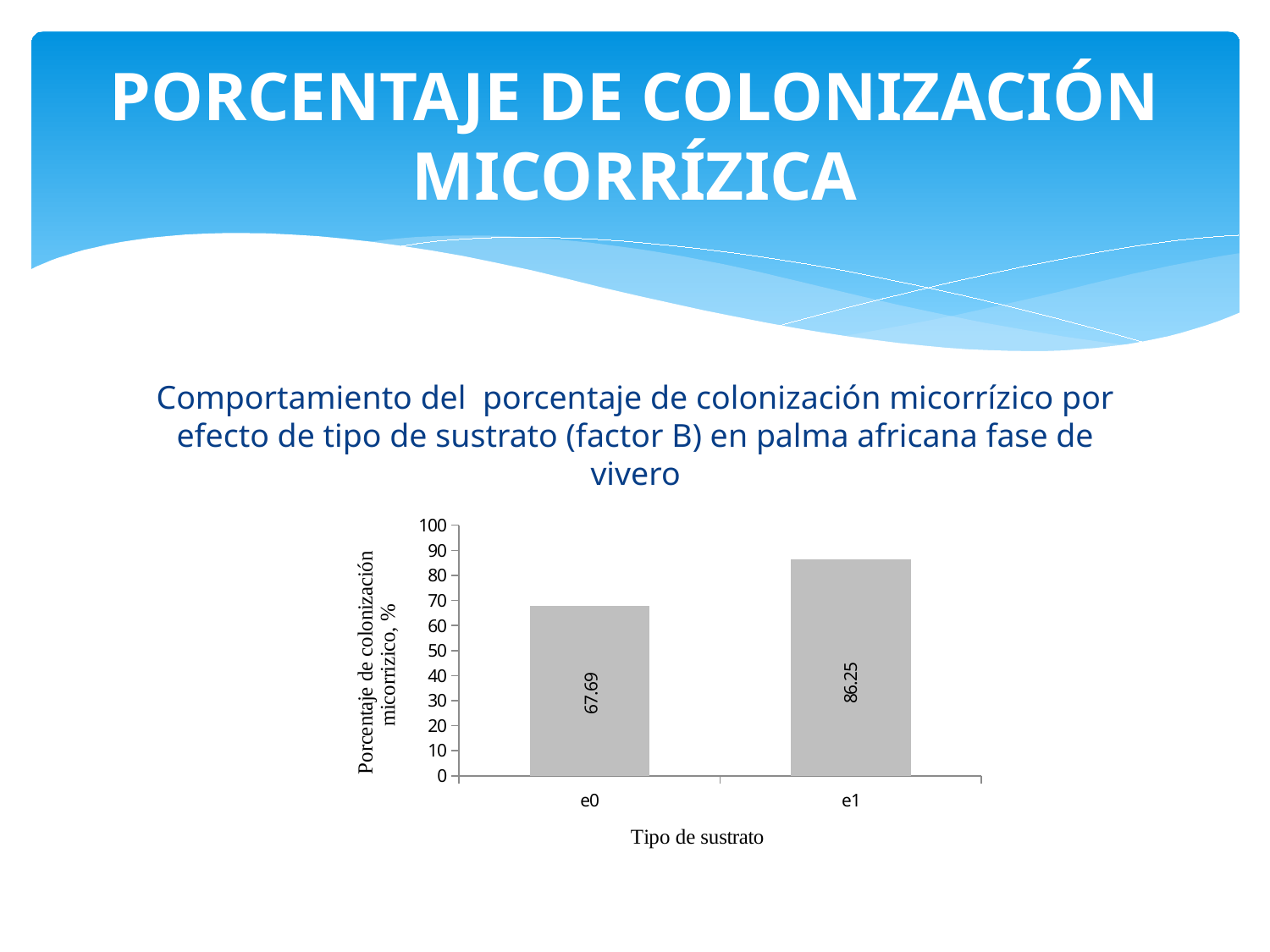
What kind of chart is shown on the slide? bar chart What is the value for e1? 86.25 Is the value for e0 greater or less than 70? less How many substrate types are shown on the x axis? 2 Do the values rise or fall from e0 to e1? rise Which is larger, the value for e0 or the value for e1? e1 What is the difference between the values for e1 and e0? 18.56 Which substrate type has the lowest percentage of mycorrhizal colonization? e0 What is the value for e0? 67.69 Is the value for e1 greater or less than 80? greater Which substrate type has the highest percentage of mycorrhizal colonization? e1 What is the label of the x axis? Tipo de sustrato